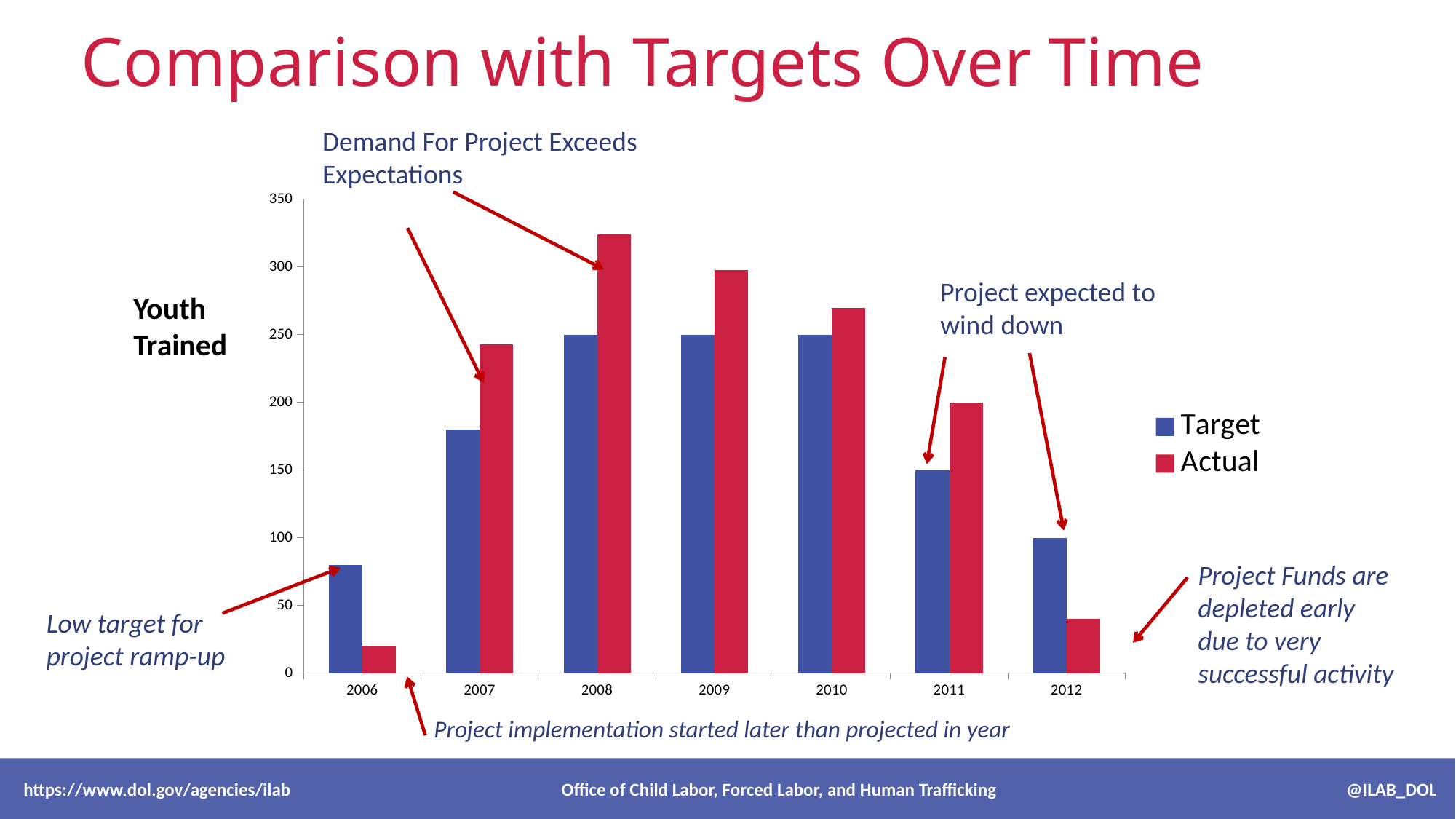
What kind of chart is shown on the slide? bar chart Is the Actual value for 2008 greater or less than 300? greater What is the Target value for 2012? 100 Do the Target values rise or fall from 2010 to 2012? fall How many series does the legend list? 2 Is the Actual value for 2006 greater or less than 50? less In which year is the Actual value highest? 2008 Is the Actual value for 2007 greater or less than 200? greater How many years are shown on the x axis? 7 In which year is the Actual value lowest? 2006 In 2008, which is larger, Target or Actual? Actual In 2012, which is larger, Target or Actual? Target